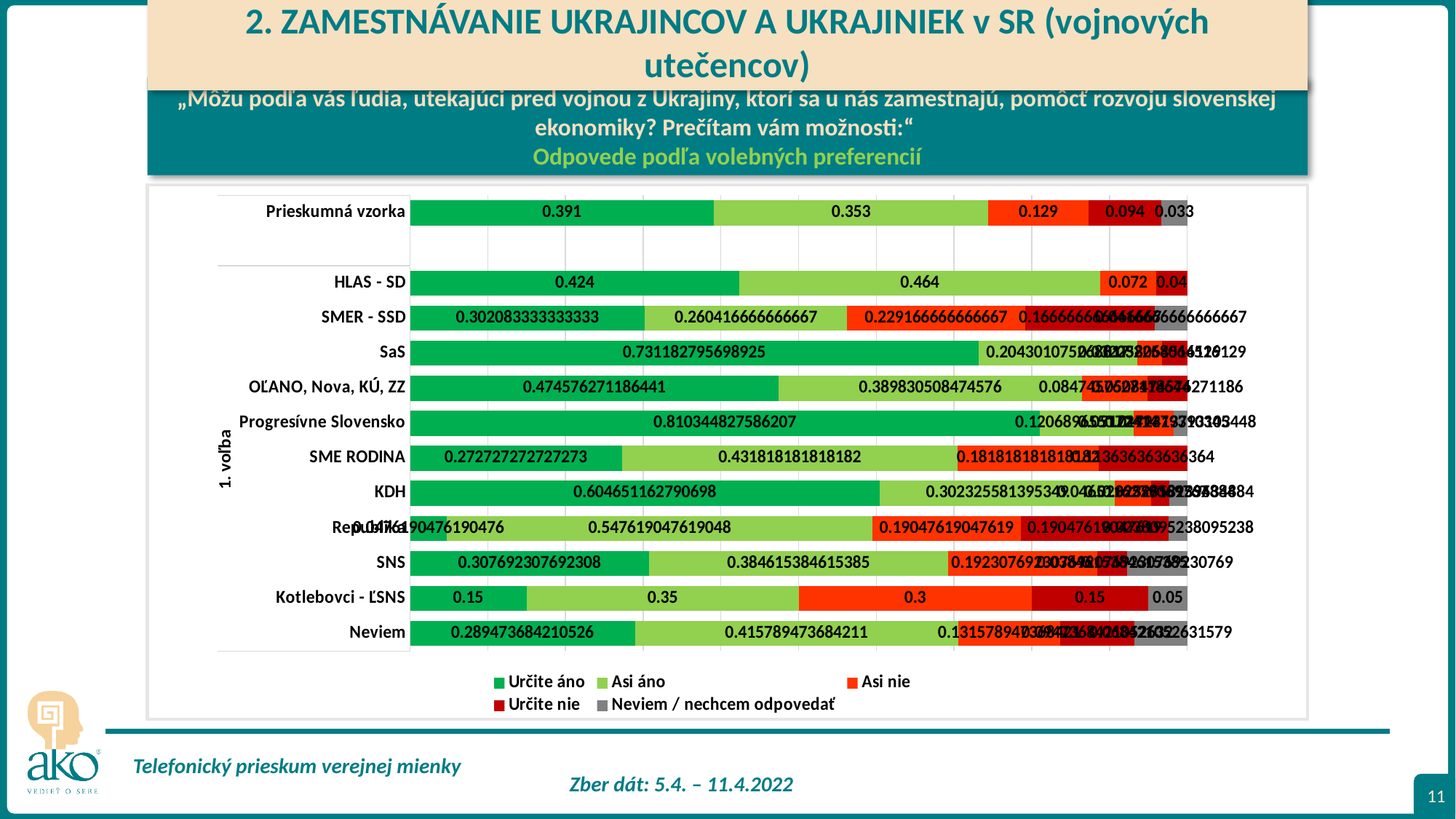
What is the value of "Asi nie" for Kotlebovci - ĽSNS? 0.3 For HLAS - SD, what is the difference between "Asi áno" and "Určite áno"? 0.04 What is the value of "Určite áno" for SaS? 0.731182795698925 Which category has the lowest "Určite áno" value? Republika What is the value of "Určite áno" for Prieskumná vzorka? 0.391 How many categories (bars) are plotted on the chart? 12 How many series does the legend list? 5 What kind of chart is shown on the slide? Stacked bar chart What is the total of the Prieskumná vzorka bar? 1 For Kotlebovci - ĽSNS, which is larger: "Asi áno" or "Asi nie"? Asi áno Which category has the highest "Určite áno" value? Progresívne Slovensko